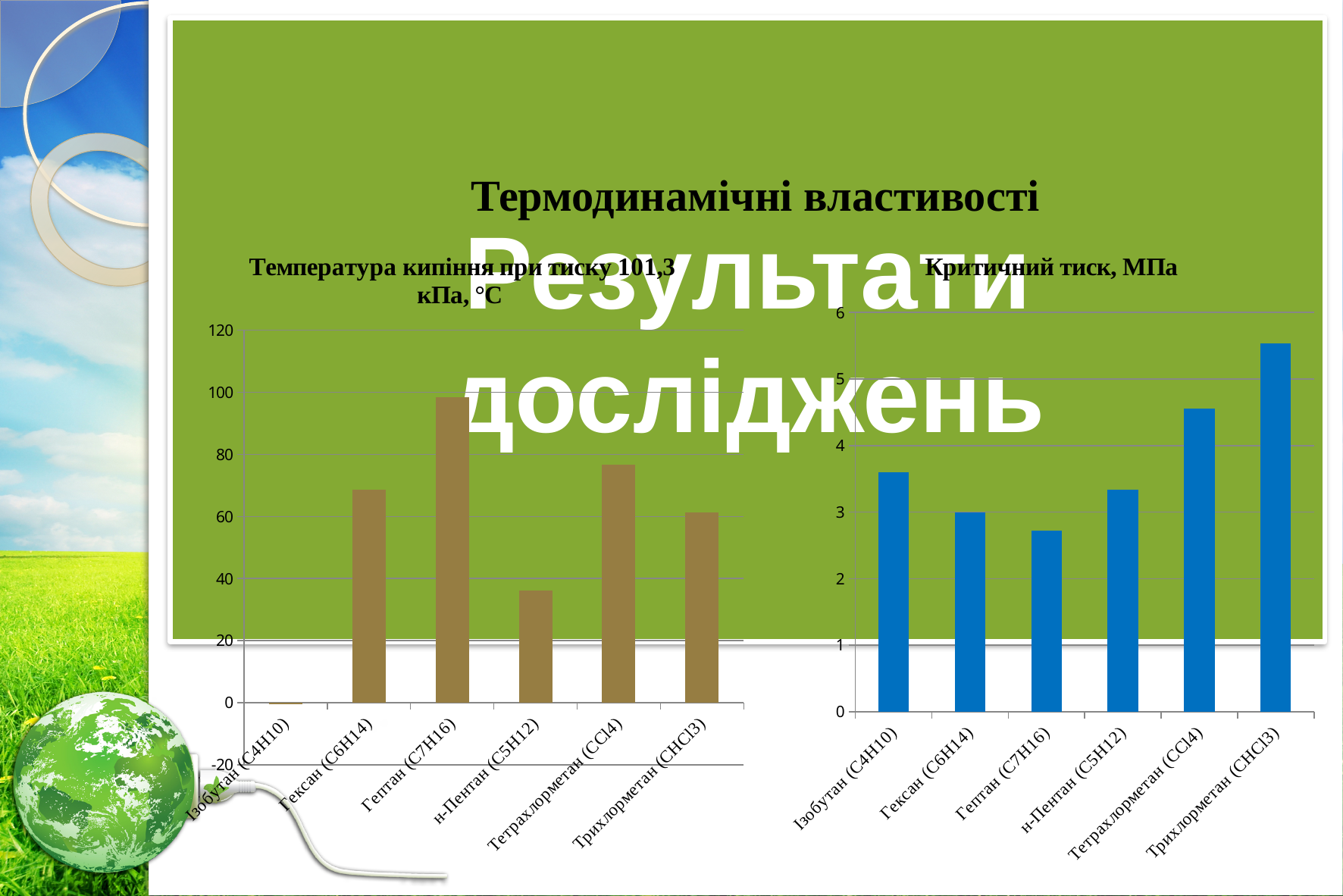
What is the overall title shown above the two charts? Термодинамічні властивості What kind of chart is the left chart, "Температура кипіння при тиску 101,3 кПа, °C"? Bar chart On the left chart, "Температура кипіння при тиску 101,3 кПа, °C", which category has the highest value? Гептан (C7H16) On the left chart, "Температура кипіння при тиску 101,3 кПа, °C", is the value for н-Пентан (C5H12) greater or less than 20? greater On the right chart, "Критичний тиск, МПа", which category has the lowest value? Гептан (C7H16) How many categories are shown on the right chart, "Критичний тиск, МПа"? 6 On the left chart, "Температура кипіння при тиску 101,3 кПа, °C", which category has the lowest value? Ізобутан (C4H10) On the right chart, "Критичний тиск, МПа", which category has the highest value? Трихлорметан (CHCl3) On the right chart, "Критичний тиск, МПа", is the value for Трихлорметан (CHCl3) greater or less than 5? greater On the right chart, "Критичний тиск, МПа", which is larger: the value for Тетрахлорметан (CCl4) or Гексан (C6H14)? Тетрахлорметан (CCl4) On the left chart, "Температура кипіння при тиску 101,3 кПа, °C", which is larger: the value for Гептан (C7H16) or Тетрахлорметан (CCl4)? Гептан (C7H16) On the left chart, "Температура кипіння при тиску 101,3 кПа, °C", is the value for Гексан (C6H14) greater or less than 60? greater